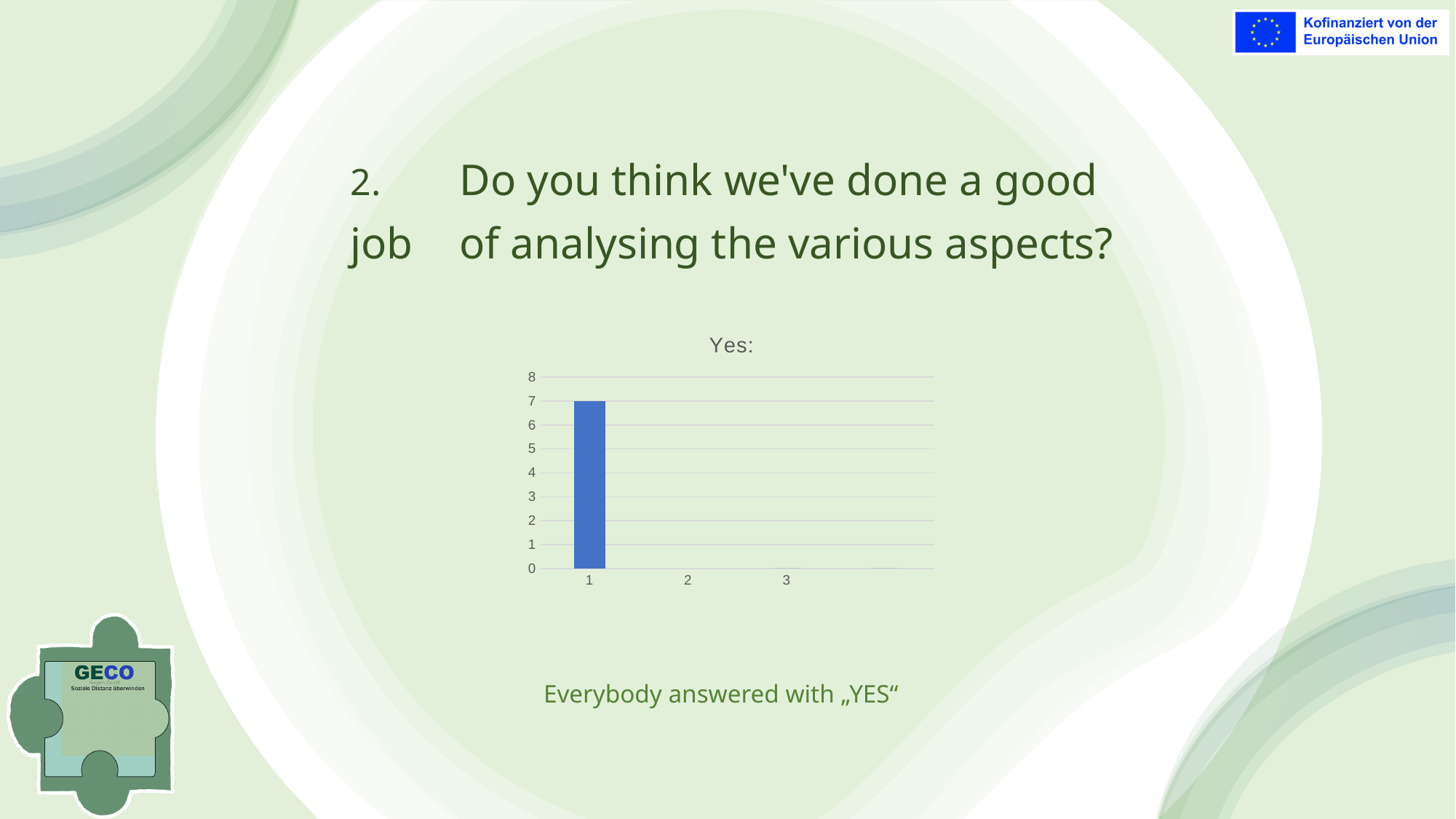
What is the title of the chart? Yes: Which category has the highest value in the chart? 1 What is the highest tick value shown on the y axis of the chart? 8 Is the value for category 1 greater or less than 5? greater Which is larger, the value for category 1 or the value for category 2? category 1 How many categories are shown on the x axis of the chart? 3 What is the value for category 1 in the chart? 7 Is the value for category 1 greater or less than 8? less Do the values rise or fall from category 1 to category 3? fall What kind of chart is shown on the slide? bar chart